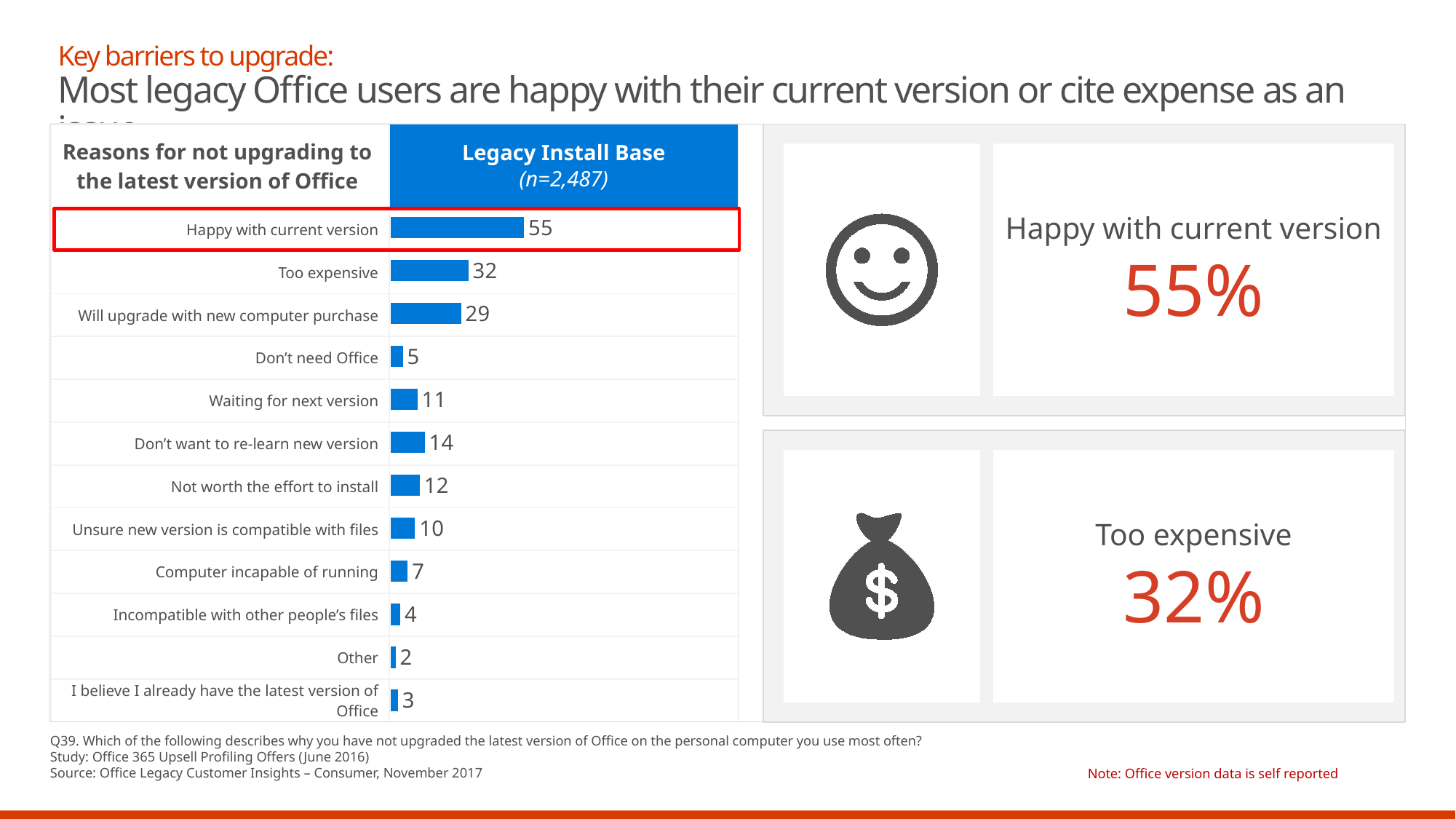
Which is larger: the value for "Waiting for next version" or "Not worth the effort to install"? Not worth the effort to install What is the value for "Happy with current version" in the Legacy Install Base chart? 55 What is the value for "Computer incapable of running"? 7 What is the sample size (n) shown for the Legacy Install Base? 2,487 What is the value for "Don't want to re-learn new version"? 14 Which reason for not upgrading has the lowest value? Other What is the value for "Will upgrade with new computer purchase"? 29 What kind of chart is used to show the reasons for not upgrading? Bar chart What is the difference between the values for "Too expensive" and "Will upgrade with new computer purchase"? 3 How many reasons for not upgrading are listed in the chart? 12 Which reason for not upgrading has the highest value? Happy with current version What is the difference between the values for "Happy with current version" and "Too expensive"? 23